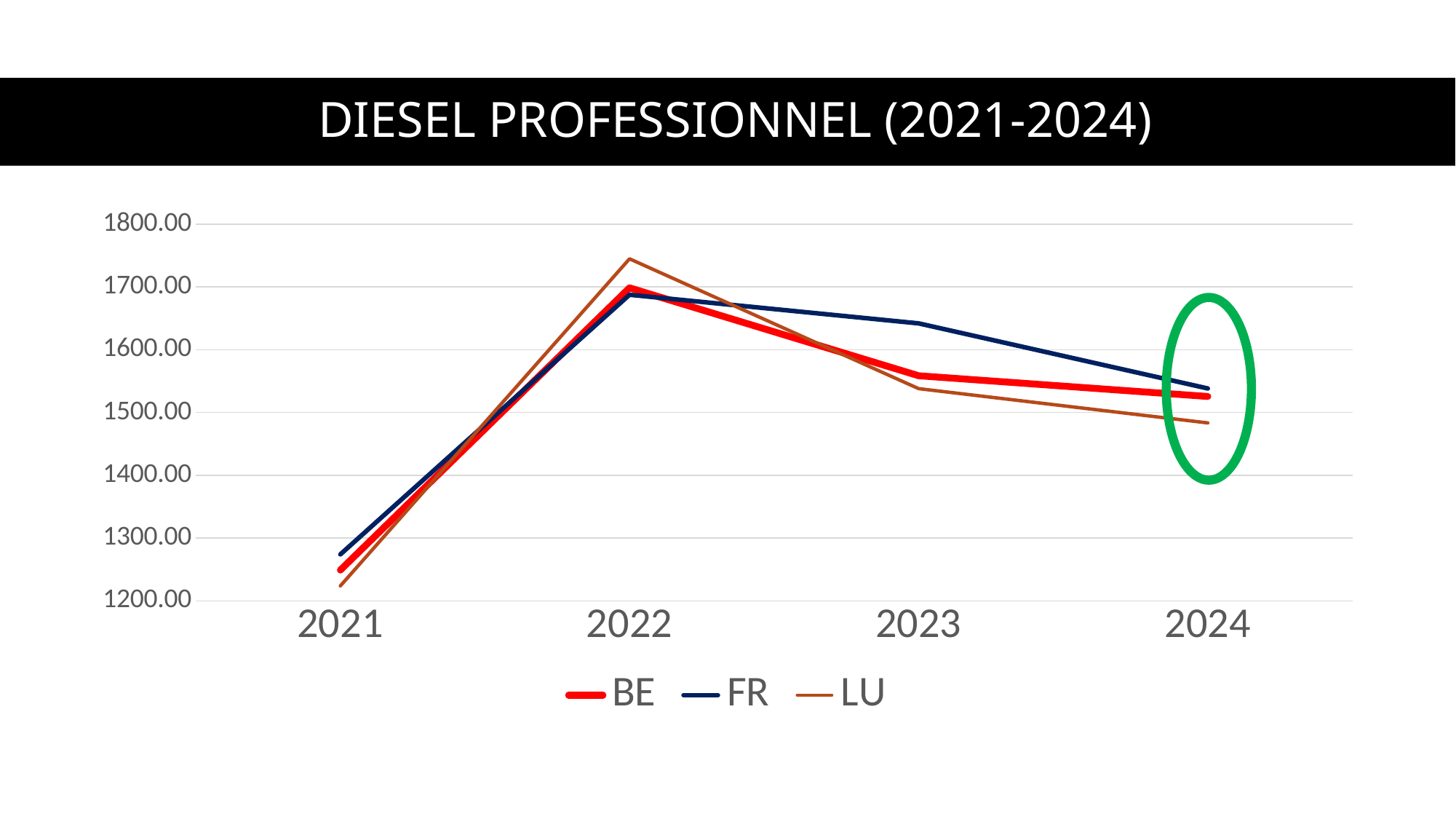
Which series has the highest value in 2024? FR How many years are plotted along the x axis? 4 What is the title of the chart? DIESEL PROFESSIONNEL (2021-2024) In which year is the BE series at its lowest value? 2021 How many series does the legend list? 3 Is the value for BE in 2021 greater or less than 1300.00? less Which series has the higher value in 2023, FR or LU? FR Is the value for LU in 2024 greater or less than 1500.00? less Is the value for LU in 2022 greater or less than 1700.00? greater In which year does the LU series reach its highest value? 2022 Do the values for FR rise or fall from 2022 to 2024? fall What kind of chart is shown on the slide? line chart